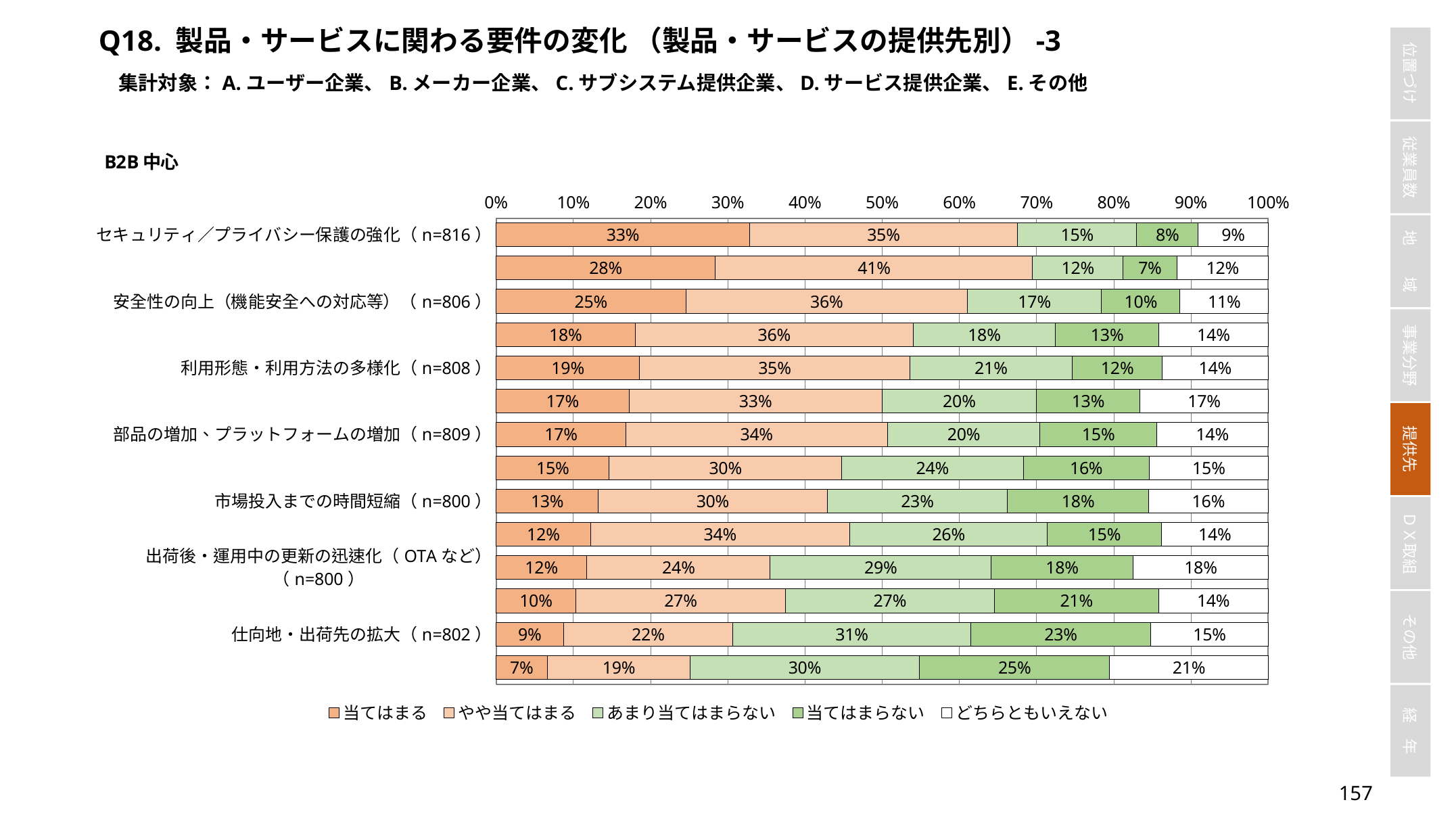
Which is larger: the 当てはまらない value for 仕向地・出荷先の拡大 (n=802) or for 利用形態・利用方法の多様化 (n=808)? 仕向地・出荷先の拡大 (n=802) What is the どちらともいえない value for 出荷後・運用中の更新の迅速化（OTAなど）(n=800)? 18% What is the difference between the 当てはまる values for セキュリティ／プライバシー保護の強化 (n=816) and 市場投入までの時間短縮 (n=800)? 20% Among the labeled categories, which has the highest 当てはまる value? セキュリティ／プライバシー保護の強化 (n=816) What kind of chart is shown on the slide? Stacked bar chart What is the last legend entry in the chart? どちらともいえない Among the labeled categories, which has the lowest 当てはまる value? 仕向地・出荷先の拡大 (n=802) How many series does the legend list? 5 What percentage of respondents answered 当てはまる for セキュリティ／プライバシー保護の強化 (n=816)? 33% What is the あまり当てはまらない value for 仕向地・出荷先の拡大 (n=802)? 31% What is the やや当てはまる value for 安全性の向上（機能安全への対応等）(n=806)? 36% What is the total of the stacked bar for 部品の増加、プラットフォームの増加 (n=809)? 100%